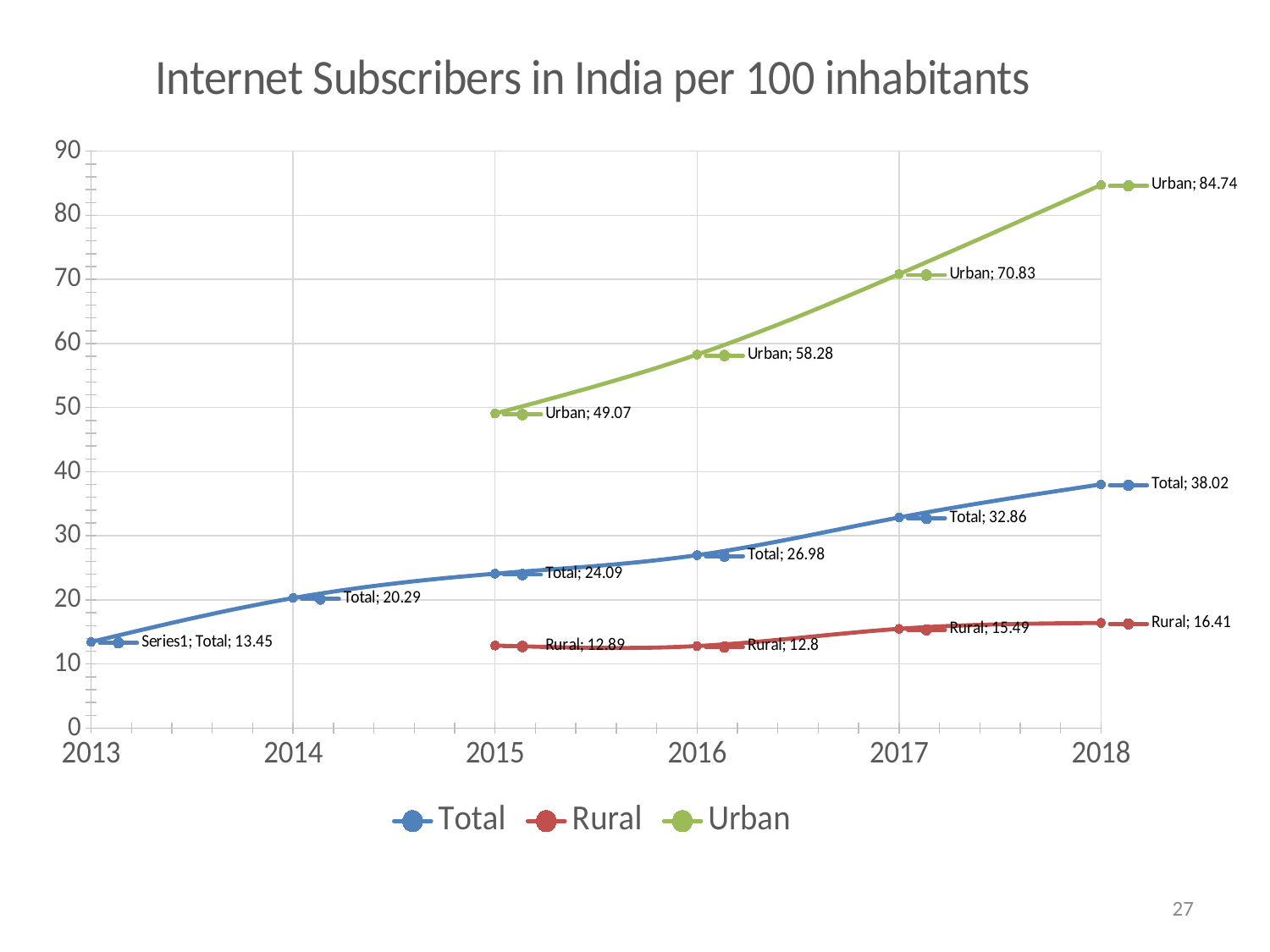
What is the Rural value in 2016? 12.8 What is the Urban value in 2018? 84.74 In which year is the Urban series highest? 2018 What is the Total value in 2013? 13.45 What is the Total value in 2017? 32.86 What is the difference between the Urban and Rural values in 2018? 68.33 What kind of chart is shown on the slide? Line chart How many series does the legend list? 3 Does the Total series rise or fall from 2013 to 2018? Rise In which year is the Rural series lowest? 2016 Which is larger in 2015, the Urban value or the Total value? Urban Is the Urban value in 2017 greater or less than 70? greater